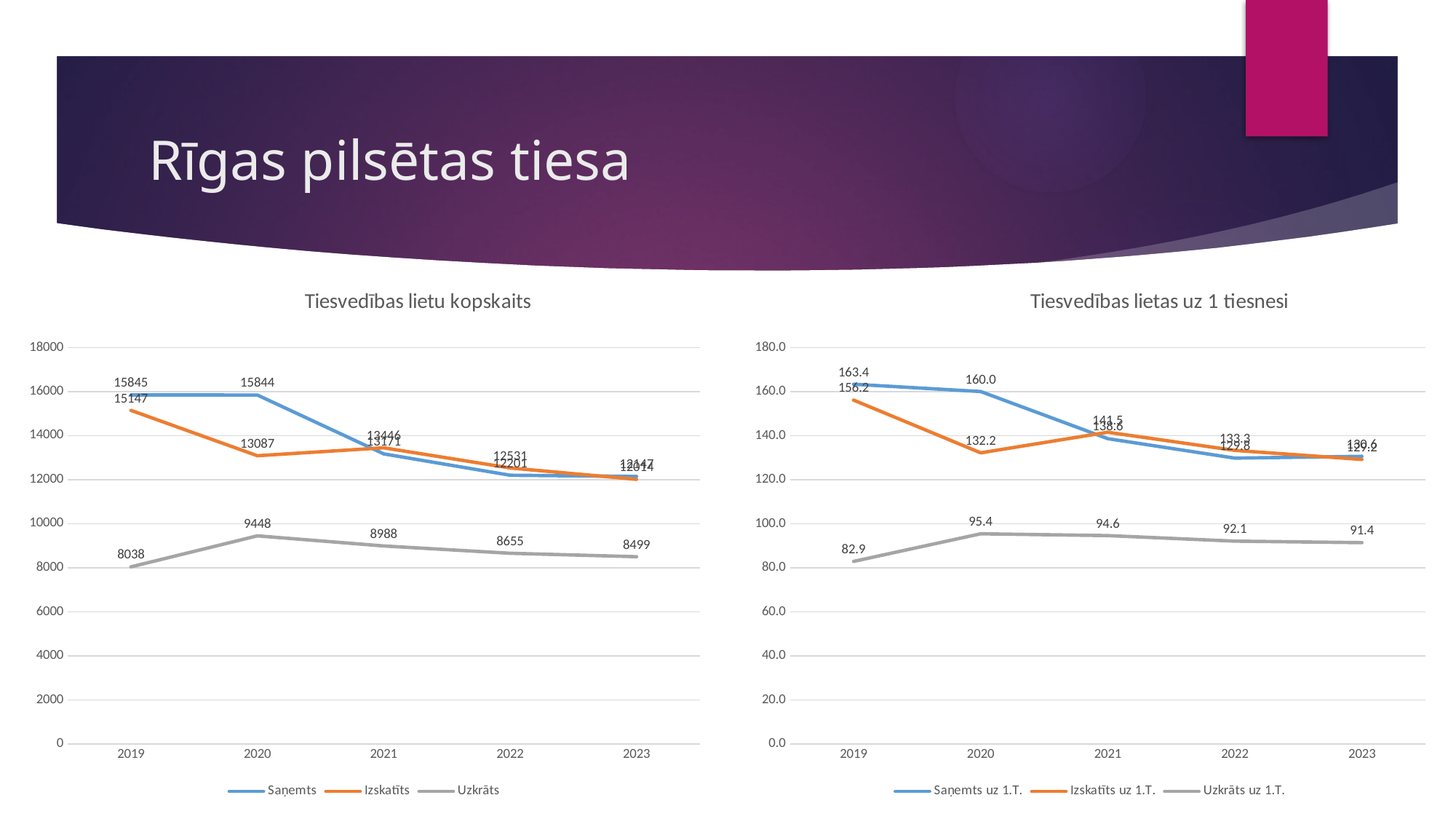
In the chart 'Tiesvedības lietas uz 1 tiesnesi', does Saņemts uz 1.T. rise or fall from 2019 to 2022? Fall In the chart 'Tiesvedības lietas uz 1 tiesnesi', what is the value of Izskatīts uz 1.T. in 2021? 141.5 In the chart 'Tiesvedības lietu kopskaits', what is the value of Izskatīts in 2020? 13087 In the chart 'Tiesvedības lietu kopskaits', what is the value of Uzkrāts in 2020? 9448 How many series does the legend of the chart 'Tiesvedības lietu kopskaits' list? 3 In the chart 'Tiesvedības lietas uz 1 tiesnesi', in which year is Uzkrāts uz 1.T. lowest? 2019 In the chart 'Tiesvedības lietu kopskaits', what is the value of Saņemts in 2019? 15845 In the chart 'Tiesvedības lietas uz 1 tiesnesi', which is larger in 2020: Saņemts uz 1.T. or Izskatīts uz 1.T.? Saņemts uz 1.T. In the chart 'Tiesvedības lietu kopskaits', what is the difference between Saņemts and Izskatīts in 2019? 698 What kind of chart is 'Tiesvedības lietu kopskaits'? Line chart In the chart 'Tiesvedības lietas uz 1 tiesnesi', what is the value of Uzkrāts uz 1.T. in 2019? 82.9 In the chart 'Tiesvedības lietu kopskaits', in which year is Uzkrāts highest? 2020